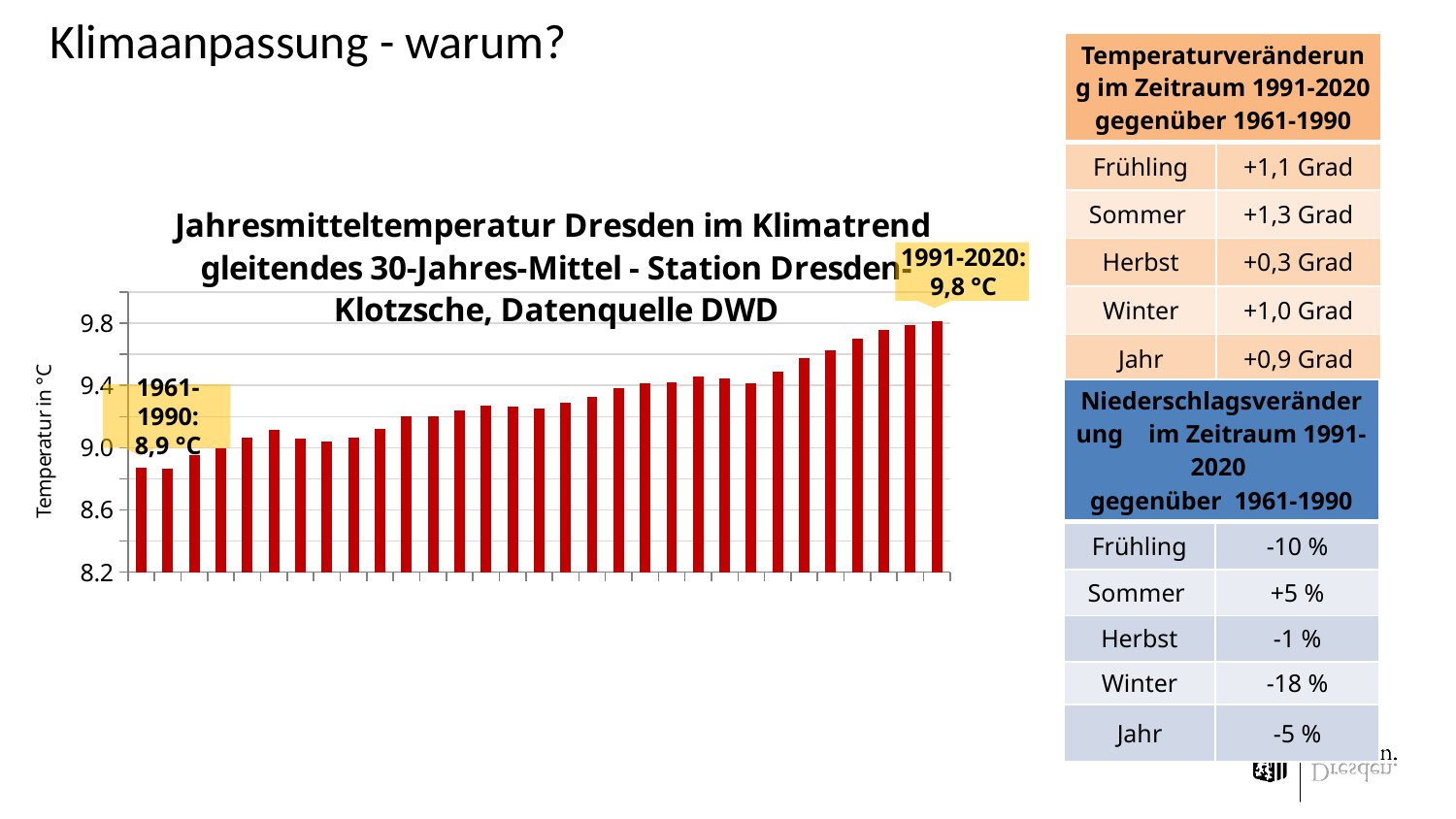
Which labelled period has the highest bar in the chart? 1991-2020 What is the label of the vertical axis of the chart? Temperatur in °C What is the 30-year mean temperature for the period 1991-2020 shown in the chart callout? 9,8 °C Which of the two labelled periods, 1961-1990 or 1991-2020, has the higher mean temperature? 1991-2020 By how much does the 1991-2020 mean temperature exceed the 1961-1990 mean temperature in the chart? 0,9 °C Is the value of the first (leftmost) bar greater or less than 9.0? less What is the lowest tick value shown on the vertical axis? 8.2 Do the bar values generally rise or fall from left to right along the x axis? rise Is the value of the last (rightmost) bar greater or less than 9.4? greater What kind of chart is shown on the slide? bar chart What is the 30-year mean temperature for the period 1961-1990 shown in the chart callout? 8,9 °C According to the chart title, which station's data is shown? Dresden-Klotzsche